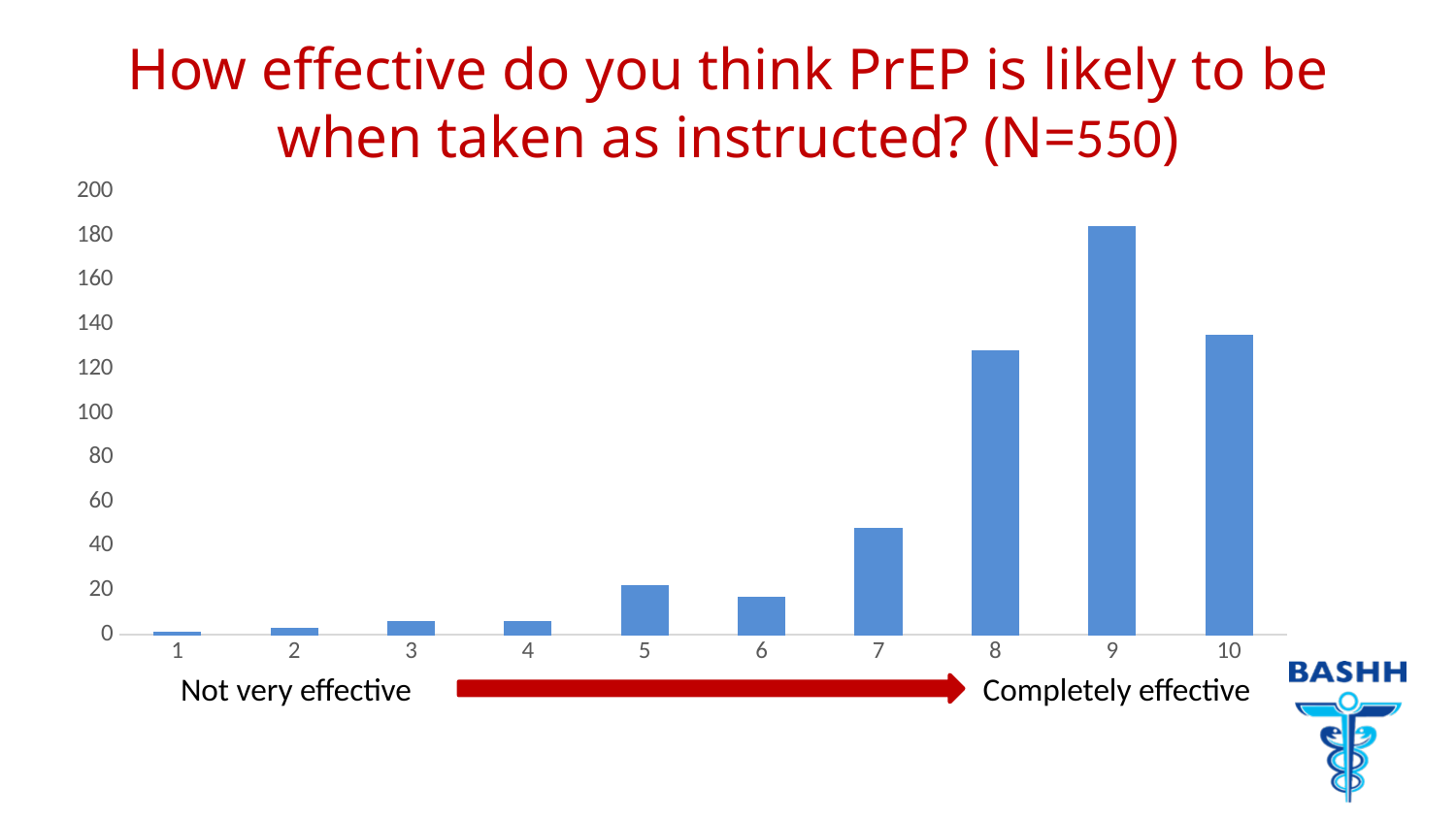
Is the value for rating 5 greater or less than 40? less Which has more responses, rating 7 or rating 8? 8 Is the value for rating 7 greater or less than 60? less Is the value for rating 9 greater or less than 160? greater Which has more responses, rating 2 or rating 9? 9 Do the values generally rise or fall from rating 1 to rating 9? rise What sample size (N) is given in the chart title? 550 Which rating category has the highest number of responses? 9 How many rating categories are shown on the x axis? 10 What kind of chart is shown on the slide? bar chart Which rating category has the lowest number of responses? 1